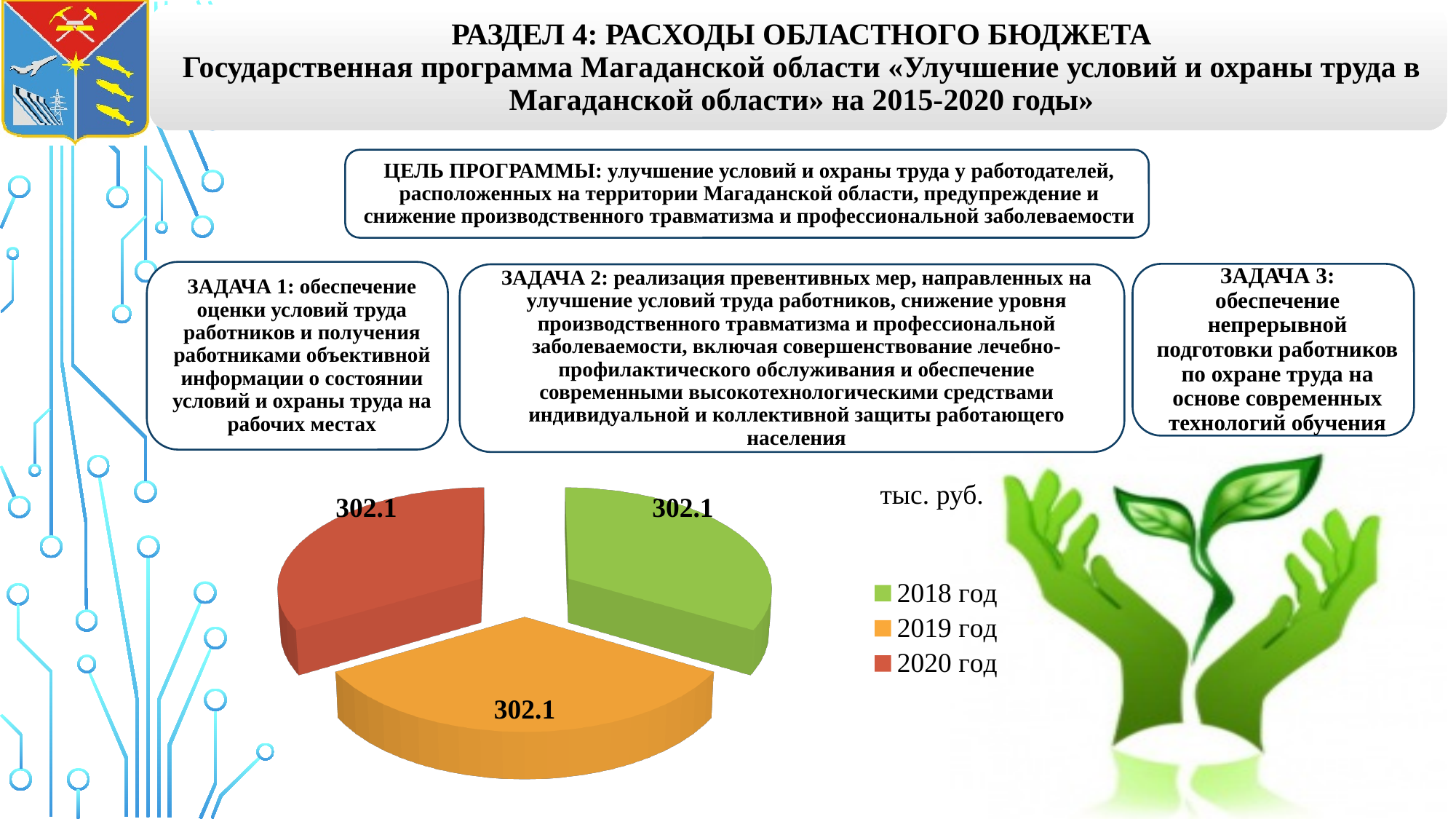
How many slices does the pie chart have? 3 What is the value for 2020 год in the pie chart? 302.1 What is the total of all three slices in the pie chart? 906.3 What is the value for 2018 год in the pie chart? 302.1 Which colour represents 2019 год in the pie chart? orange Is the value for 2020 год in the pie chart greater or less than 300? greater What is the value for 2019 год in the pie chart? 302.1 What kind of chart is shown on the slide? pie chart What is the difference between the values for 2018 год and 2020 год in the pie chart? 0 What unit is indicated next to the pie chart? тыс. руб. How many entries does the legend of the pie chart list? 3